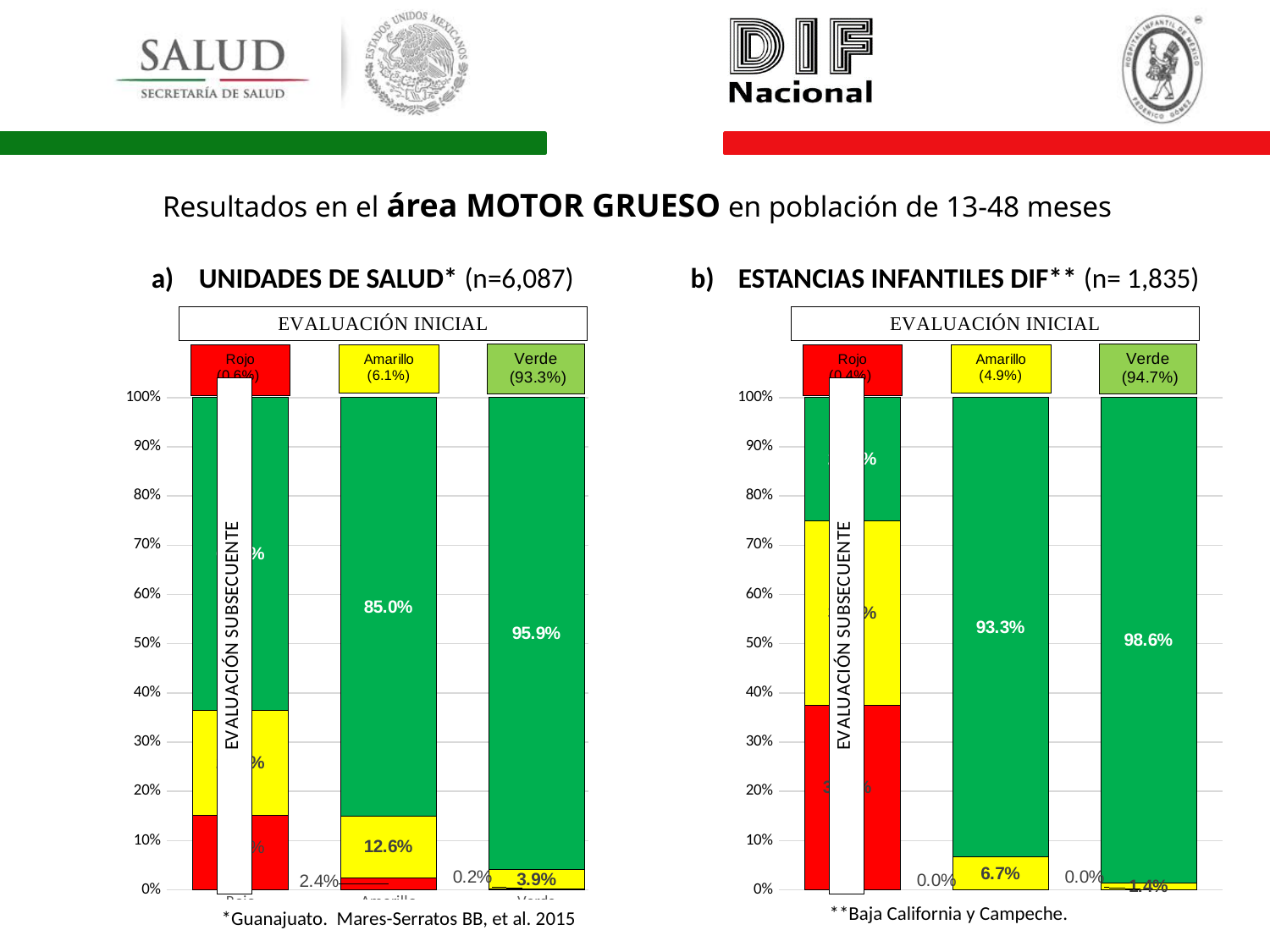
In chart a) UNIDADES DE SALUD, what percentage of children initially evaluated as Amarillo were Verde in the subsequent evaluation? 85.0% In chart b) ESTANCIAS INFANTILES DIF, what is the yellow (Amarillo) share of the Amarillo bar? 6.7% In chart b) ESTANCIAS INFANTILES DIF, what percentage of the initial evaluation was Amarillo, as shown in the header above the bars? 4.9% What type of chart is used in chart a) UNIDADES DE SALUD? Stacked bar chart In chart b) ESTANCIAS INFANTILES DIF, which is larger: the green share of the Amarillo bar or the green share of the Verde bar? Verde bar (98.6%) In chart a) UNIDADES DE SALUD, what percentage of the initial evaluation was Verde, as shown in the header above the bars? 93.3% What is the sample size (n) stated for chart b) ESTANCIAS INFANTILES DIF? 1,835 In chart b) ESTANCIAS INFANTILES DIF, what percentage of children initially evaluated as Verde remained Verde in the subsequent evaluation? 98.6% How many initial-evaluation categories (bars) are shown in chart b) ESTANCIAS INFANTILES DIF? 3 In chart a) UNIDADES DE SALUD, what is the yellow (Amarillo) share of the Amarillo bar? 12.6% In chart a) UNIDADES DE SALUD, what is the difference between the green share of the Verde bar (95.9%) and the green share of the Amarillo bar (85.0%)? 10.9% In chart a) UNIDADES DE SALUD, what percentage of children initially evaluated as Verde remained Verde in the subsequent evaluation? 95.9%